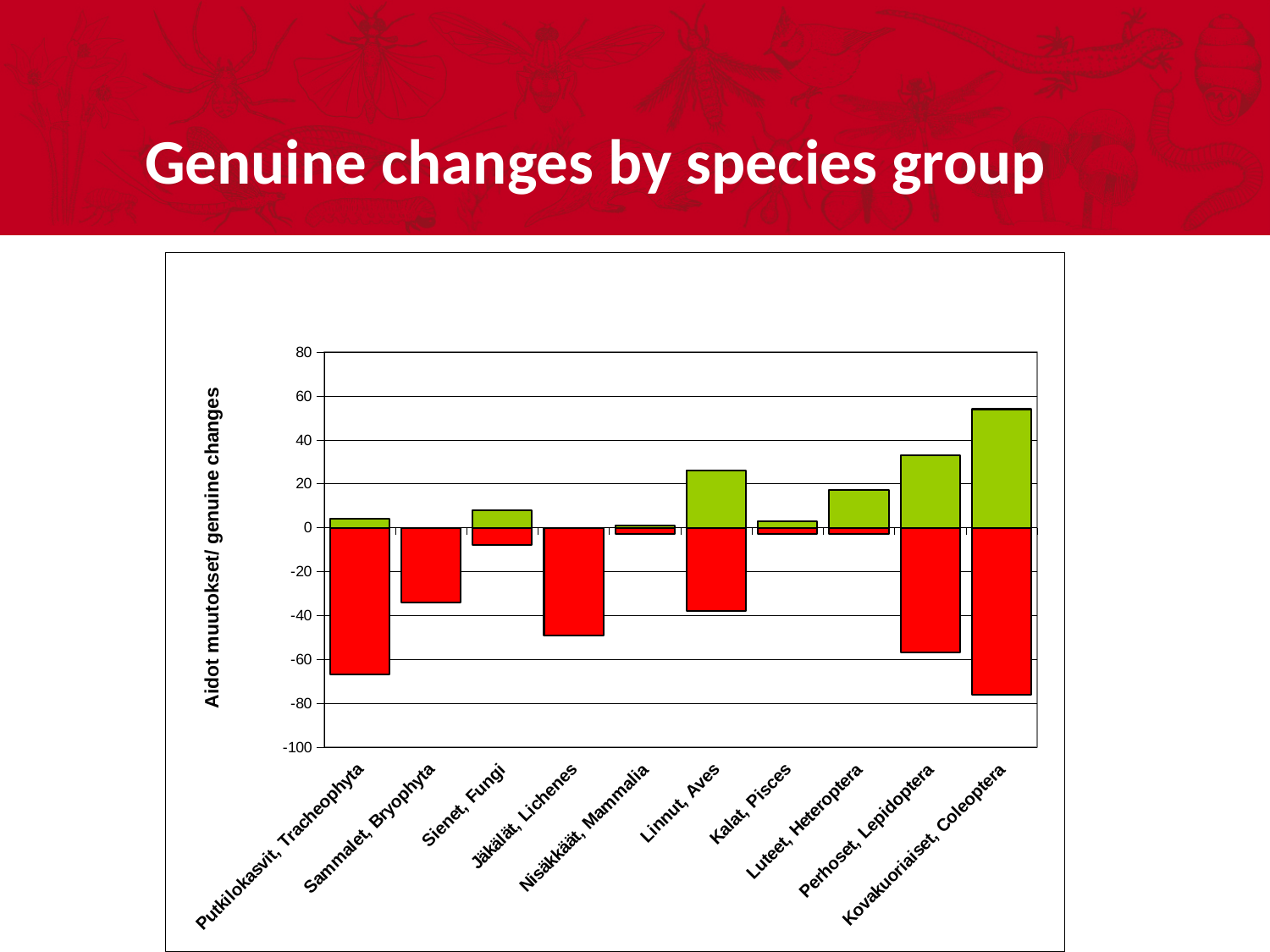
Which has the taller green bar, Perhoset, Lepidoptera or Luteet, Heteroptera? Perhoset, Lepidoptera Is the green bar for Linnut, Aves greater or less than 20? greater What is the title of the slide? Genuine changes by species group Is the red bar for Sammalet, Bryophyta greater or less than -40? greater Which species group has the tallest green (positive) bar? Kovakuoriaiset, Coleoptera Which species group has the longest red (negative) bar? Kovakuoriaiset, Coleoptera Is the green bar for Kovakuoriaiset, Coleoptera greater or less than 40? greater Which has the longer red bar, Jäkälät, Lichenes or Sienet, Fungi? Jäkälät, Lichenes How many species groups are shown on the x axis of the chart? 10 What is the label on the vertical axis of the chart? Aidot muutokset/ genuine changes What kind of chart is shown on the slide? bar chart